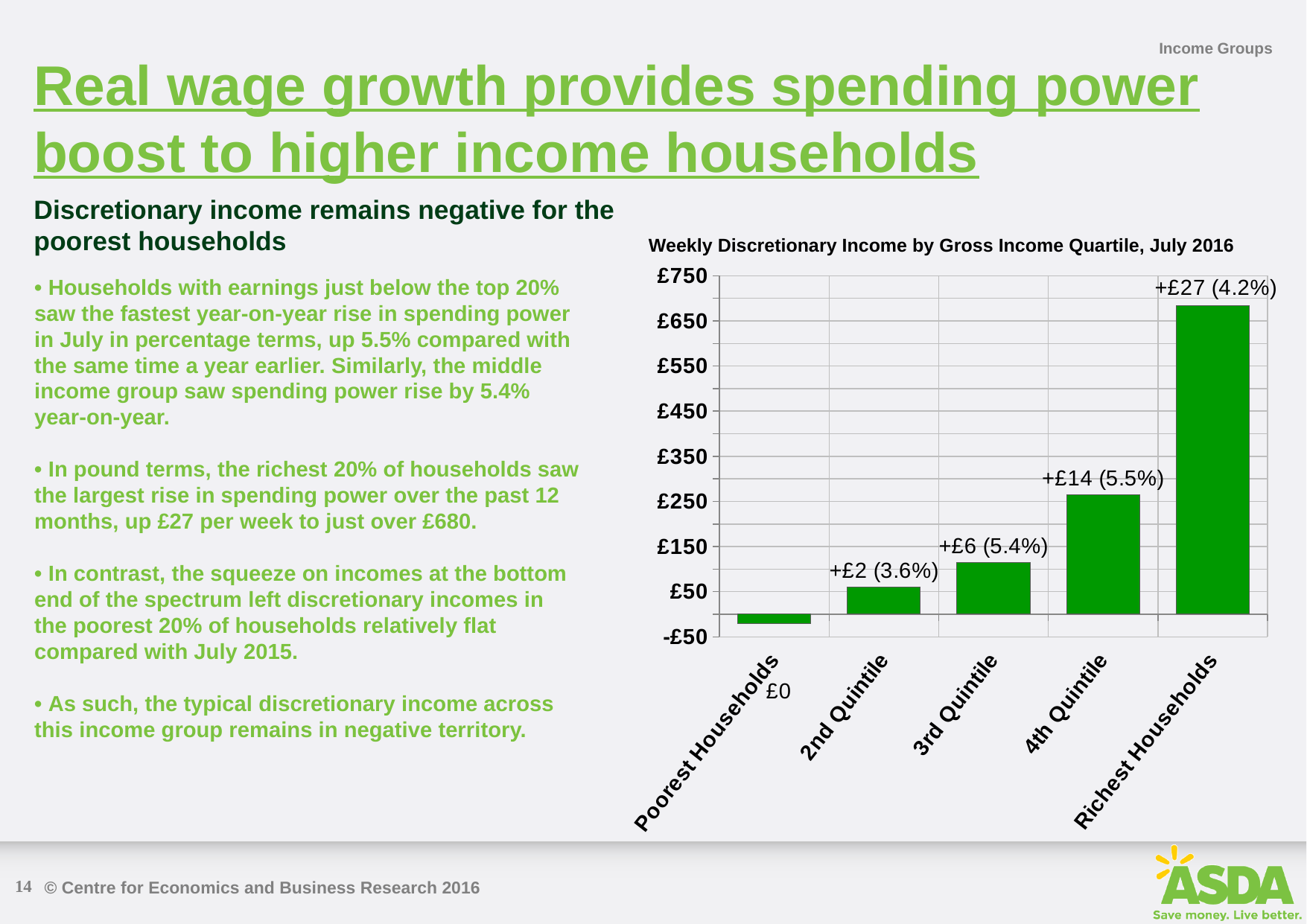
Which income group has the highest weekly discretionary income in the chart? Richest Households What is the title of the chart? Weekly Discretionary Income by Gross Income Quartile, July 2016 Is the weekly discretionary income for 3rd Quintile greater or less than £150? less How many income groups are plotted on the x axis of the chart? 5 Which income group has the lowest weekly discretionary income in the chart? Poorest Households Is the weekly discretionary income for 4th Quintile greater or less than £250? greater Is the weekly discretionary income for Poorest Households greater or less than £0? less What kind of chart is shown on the slide? bar chart What year-on-year change label is printed above the 4th Quintile bar? +£14 (5.5%) Which has the larger weekly discretionary income, 2nd Quintile or 4th Quintile? 4th Quintile Do the bar values rise or fall moving from Poorest Households to Richest Households along the x axis? rise